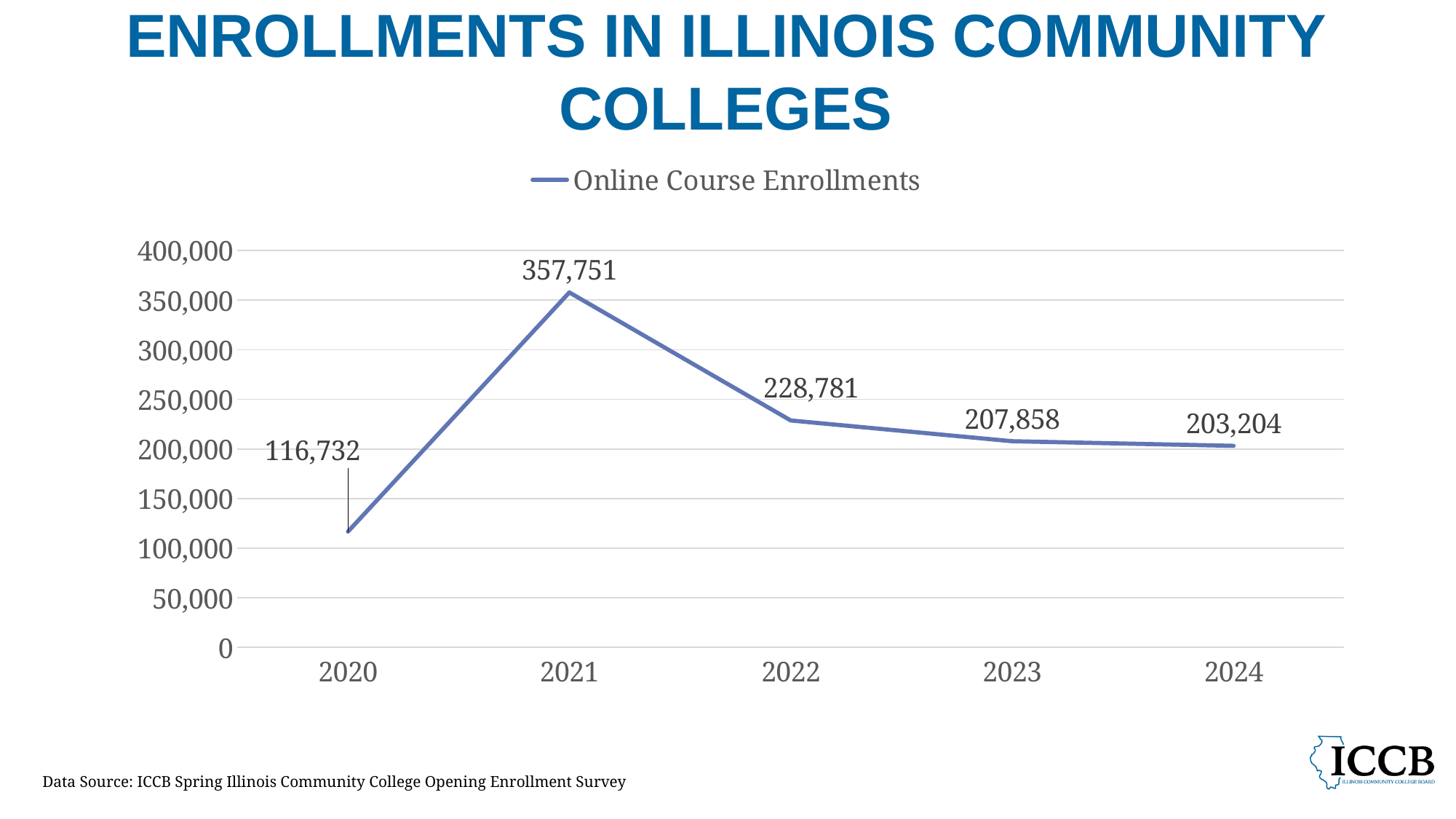
Which year had the lowest Online Course Enrollments? 2020 Which year had the highest Online Course Enrollments? 2021 Which year had more Online Course Enrollments, 2022 or 2023? 2022 Do Online Course Enrollments rise or fall from 2021 to 2024? fall What is the difference in Online Course Enrollments between 2021 and 2022? 128,970 Is the value for 2020 greater or less than 150,000? less What was the value of Online Course Enrollments in 2020? 116,732 What kind of chart is shown on the slide? line chart What is the difference in Online Course Enrollments between 2023 and 2024? 4,654 How many years are plotted on the chart? 5 What was the value of Online Course Enrollments in 2024? 203,204 What was the value of Online Course Enrollments in 2021? 357,751